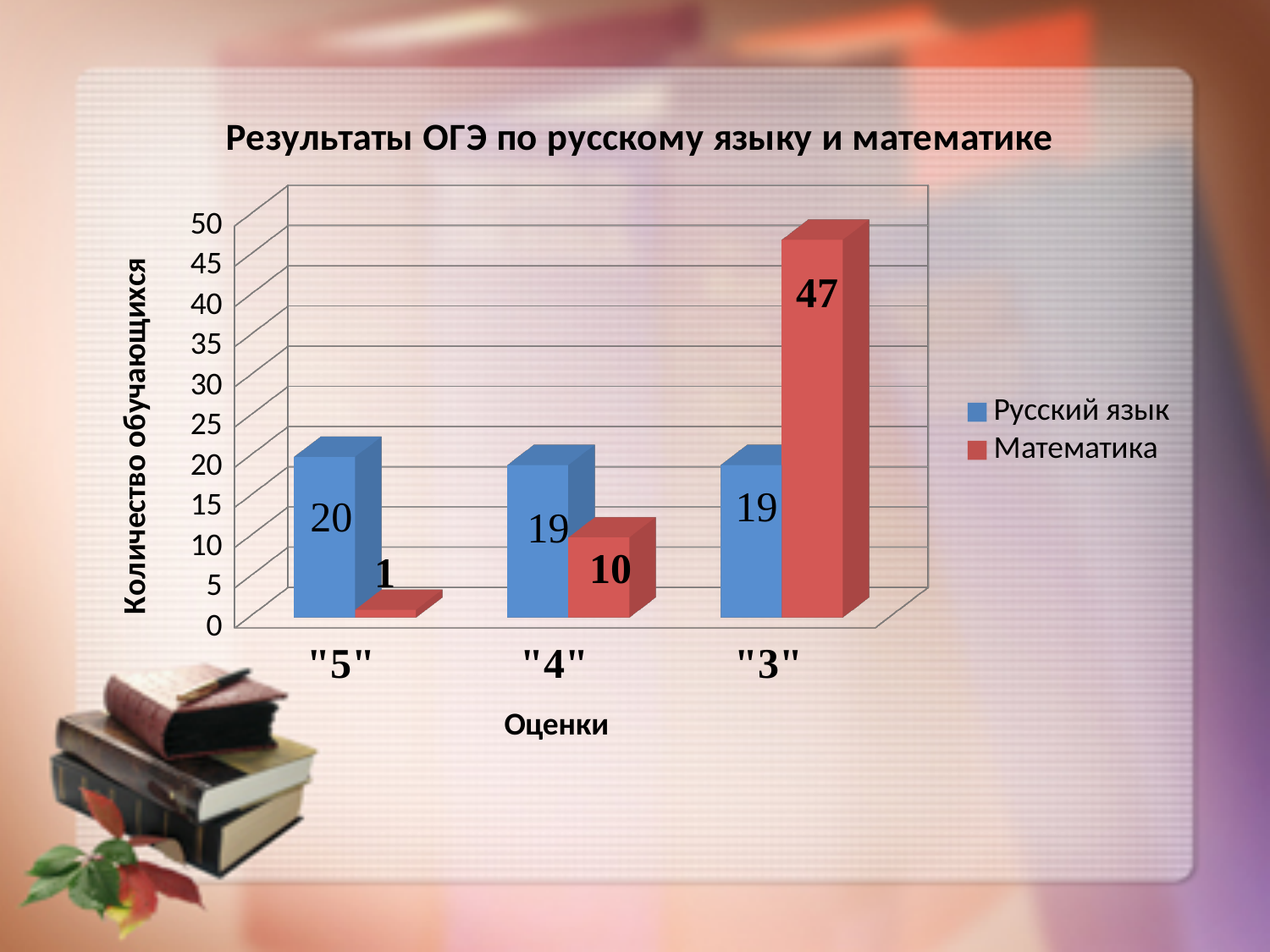
Which is larger at grade "4": Русский язык or Математика? Русский язык What kind of chart is shown on the slide? Bar chart Which grade has the highest value for Математика? "3" Which grade has the lowest value for Математика? "5" How many grade categories are shown on the x axis? 3 What is the value for Математика at grade "3"? 47 What is the difference between Математика and Русский язык at grade "3"? 28 What is the value for Русский язык at grade "5"? 20 What is the title of the chart? Результаты ОГЭ по русскому языку и математике What is the value for Математика at grade "5"? 1 What is the value for Математика at grade "4"? 10 How many series does the legend list? 2